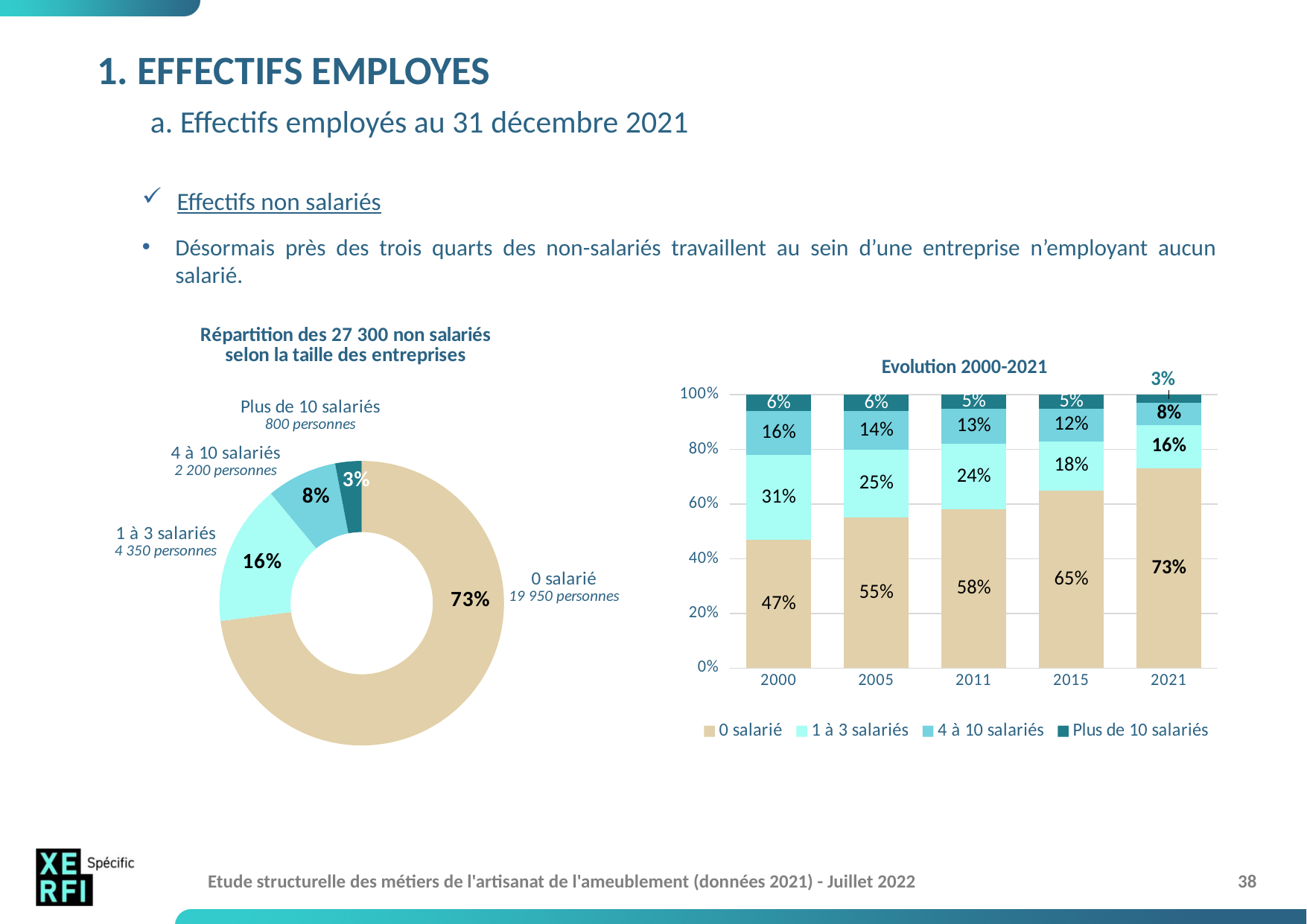
In the 'Evolution 2000-2021' chart, what is the value for '1 à 3 salariés' in 2000? 31% In the 'Evolution 2000-2021' chart, what is the difference between the '0 salarié' value in 2021 and in 2000? 26 percentage points In the 'Evolution 2000-2021' chart, which is larger: '4 à 10 salariés' in 2005 or in 2021? 2005 In the 'Répartition des 27 300 non salariés selon la taille des entreprises' chart, which category has the smallest share? Plus de 10 salariés In the 'Répartition des 27 300 non salariés selon la taille des entreprises' chart, what share is shown for '0 salarié'? 73% In the 'Répartition des 27 300 non salariés selon la taille des entreprises' chart, how many people are in the '1 à 3 salariés' category? 4 350 personnes In the 'Evolution 2000-2021' chart, does the '0 salarié' share rise or fall from 2000 to 2021? Rise In the 'Répartition des 27 300 non salariés selon la taille des entreprises' chart, how many categories are shown? 4 What kind of chart is 'Evolution 2000-2021'? Stacked bar chart What kind of chart is 'Répartition des 27 300 non salariés selon la taille des entreprises'? Doughnut (pie) chart In the 'Evolution 2000-2021' chart, what is the value for '0 salarié' in 2011? 58% In the 'Evolution 2000-2021' chart, how many series does the legend list? 4